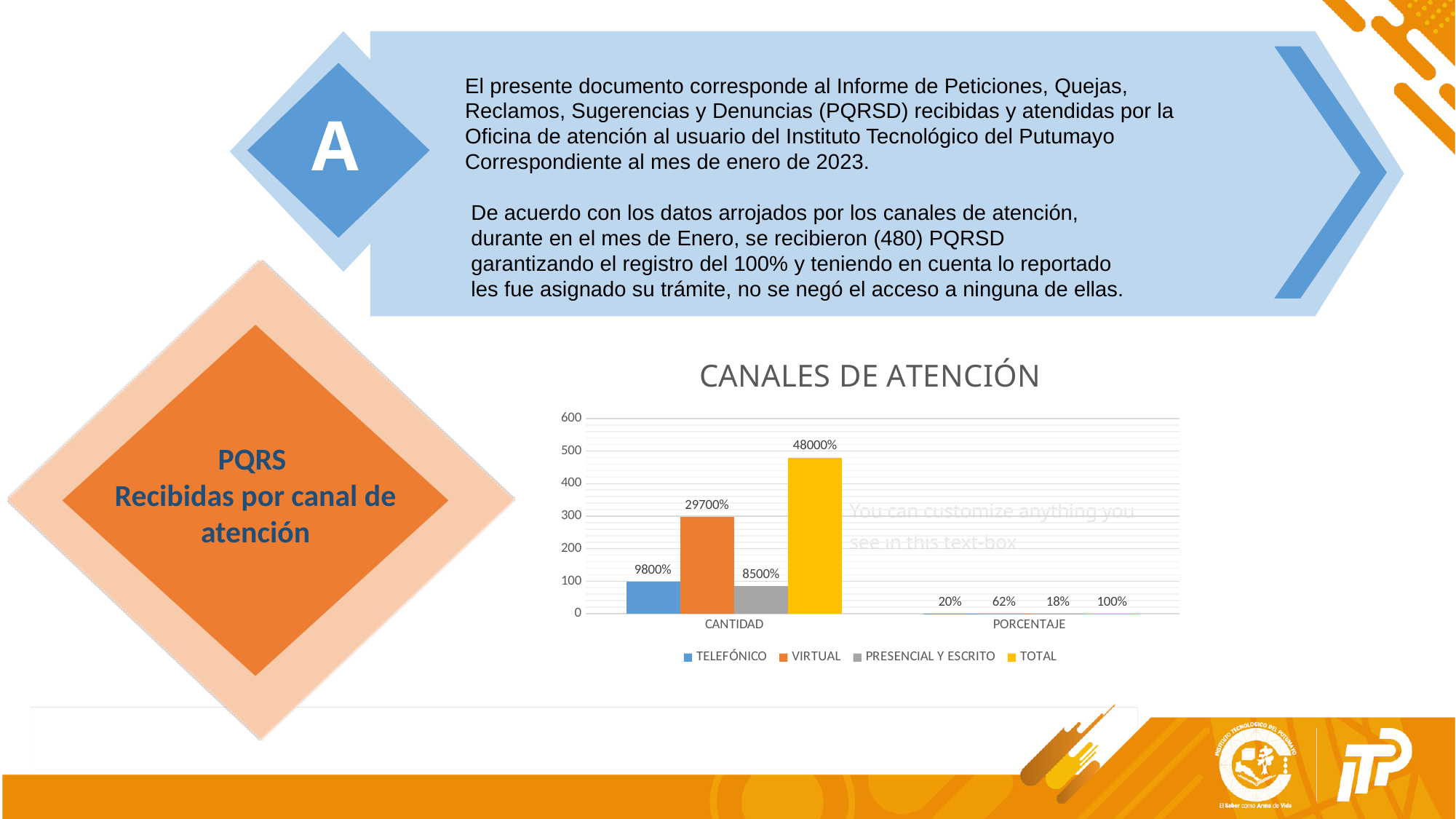
What is the difference between the VIRTUAL and TELEFÓNICO labels in the PORCENTAJE category? 42% In the CANTIDAD category, which is larger: TELEFÓNICO or PRESENCIAL Y ESCRITO? TELEFÓNICO What is the data label for TELEFÓNICO in the CANTIDAD category? 9800% What kind of chart is shown under the title CANALES DE ATENCIÓN? bar chart Which series has the shortest bar in the CANTIDAD category? PRESENCIAL Y ESCRITO What is the data label for TOTAL in the PORCENTAJE category? 100% How many series does the legend of the CANALES DE ATENCIÓN chart list? 4 What is the data label for PRESENCIAL Y ESCRITO in the PORCENTAJE category? 18% What is the data label for VIRTUAL in the CANTIDAD category? 29700% How many categories are shown on the x axis of the CANALES DE ATENCIÓN chart? 2 Is the VIRTUAL bar in the CANTIDAD category greater or less than 200 on the y axis? greater Which series has the tallest bar in the CANTIDAD category? TOTAL